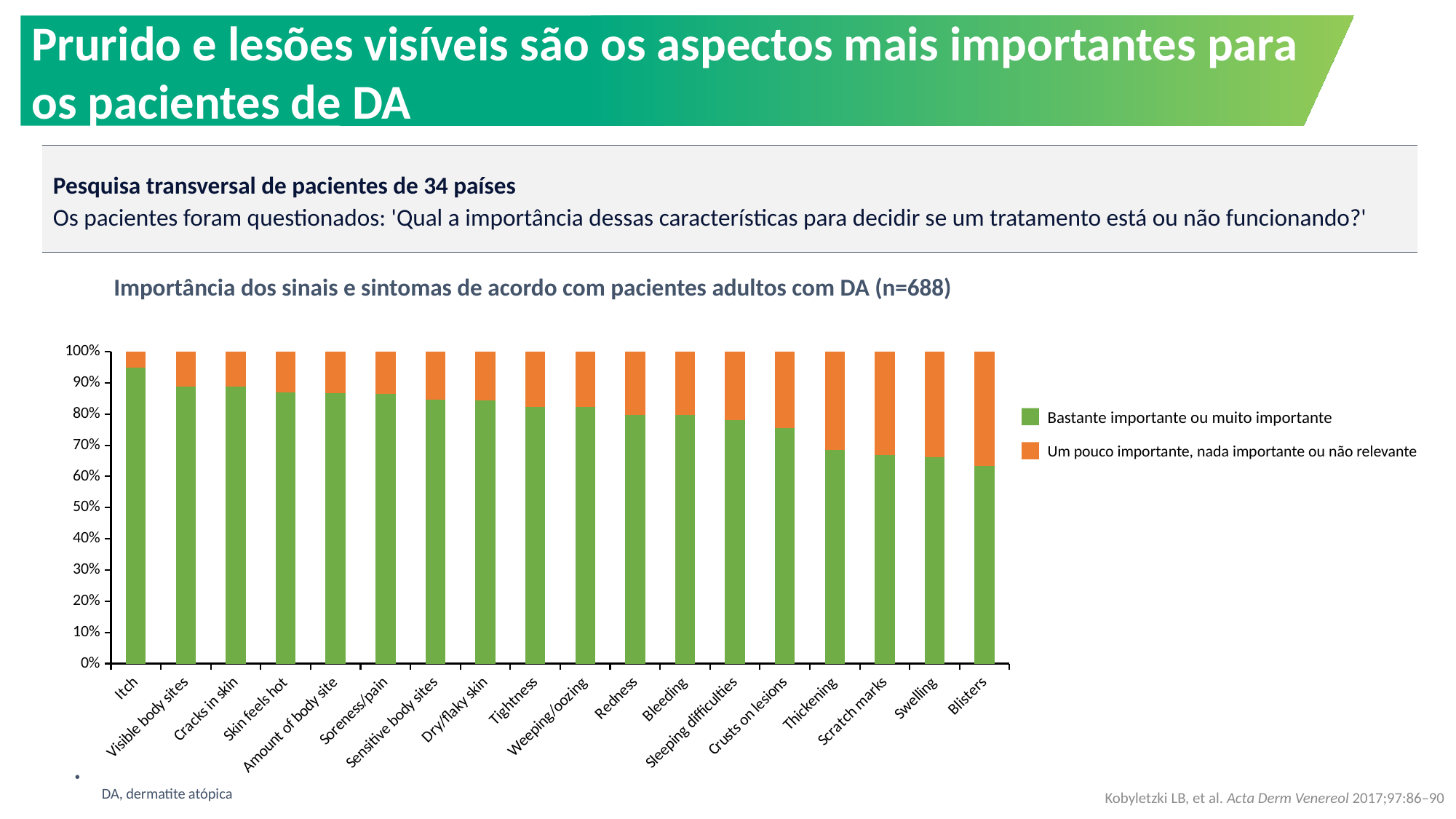
Do the 'Bastante importante ou muito importante' values rise or fall moving from left to right along the x axis? Fall Is the 'Bastante importante ou muito importante' value for Itch greater or less than 90%? greater Is the 'Bastante importante ou muito importante' value for Crusts on lesions greater or less than 70%? greater Which category has the highest share of 'Bastante importante ou muito importante'? Itch What is the total of the stacked bar for Itch? 100% How many series does the legend list? 2 Which category has the lowest share of 'Bastante importante ou muito importante'? Blisters How many signs and symptoms (categories) are plotted along the x axis? 18 Which has a larger 'Bastante importante ou muito importante' share: Itch or Blisters? Itch Is the 'Bastante importante ou muito importante' value for Blisters greater or less than 70%? less What kind of chart is shown on the slide? Stacked bar chart